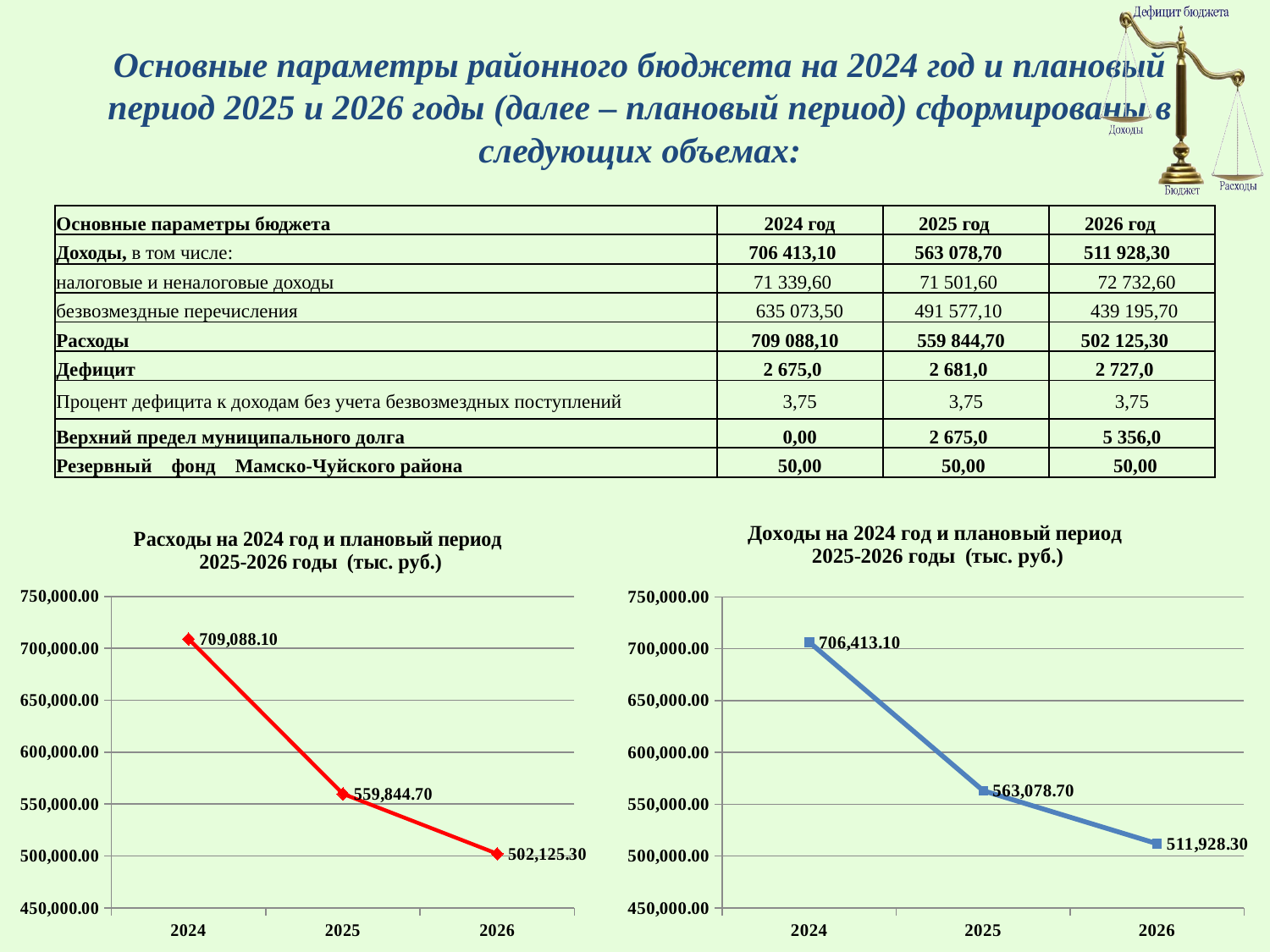
What type of chart is the right chart (Доходы)? line chart In the left chart (Расходы на 2024 год и плановый период 2025-2026 годы), what is the value for 2024? 709,088.10 In the right chart (Доходы), which year has the highest value? 2024 In the right chart (Доходы), is the value for 2025 greater or less than 600,000.00? less In the left chart (Расходы), do the values rise or fall from 2024 to 2026? fall In the right chart (Доходы на 2024 год и плановый период 2025-2026 годы), what is the value for 2026? 511,928.30 In the left chart (Расходы), what is the difference between the 2024 and 2025 values? 149,243.40 In the left chart (Расходы), what is the value for 2025? 559,844.70 Comparing the two charts, which is larger for 2025: Расходы or Доходы? Доходы In the left chart (Расходы), which year has the lowest value? 2026 In the right chart (Доходы), what is the difference between the 2024 and 2026 values? 194,484.80 How many data points are plotted in the left chart (Расходы)? 3